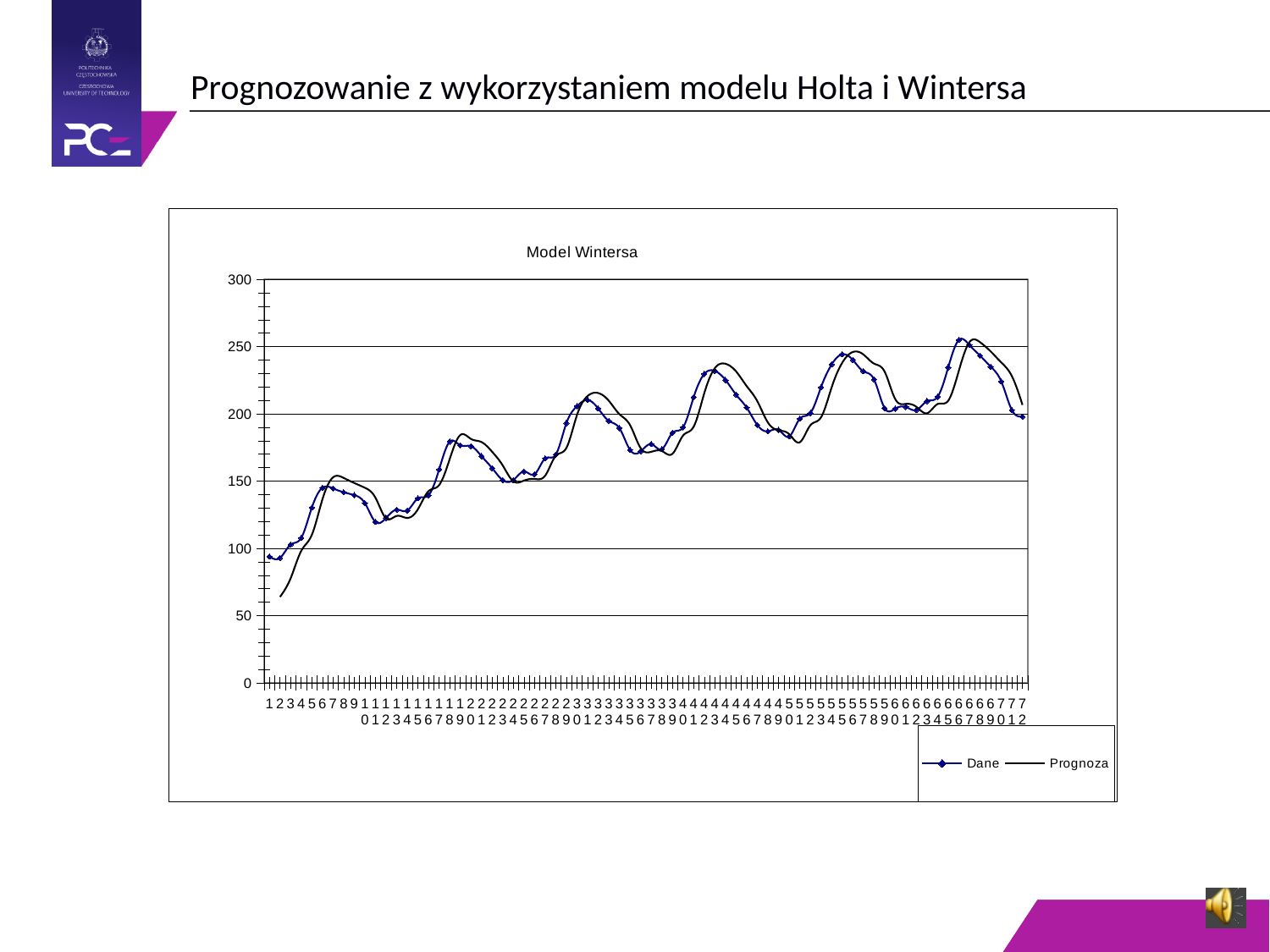
What is the title of the chart? Model Wintersa Is the value of the Dane series at point 20 greater or less than 150? greater How many series does the legend list? 2 Do the values of the Dane series rise or fall overall from left to right along the x axis? rise Is the highest value reached by the Dane series greater or less than 200? greater Is the value of the Prognoza series at point 2 greater or less than 100? less Which series are listed in the legend? Dane, Prognoza At point 2, which series has the larger value, Dane or Prognoza? Dane How many time points does the x axis span? 72 What kind of chart is shown on the slide? line chart